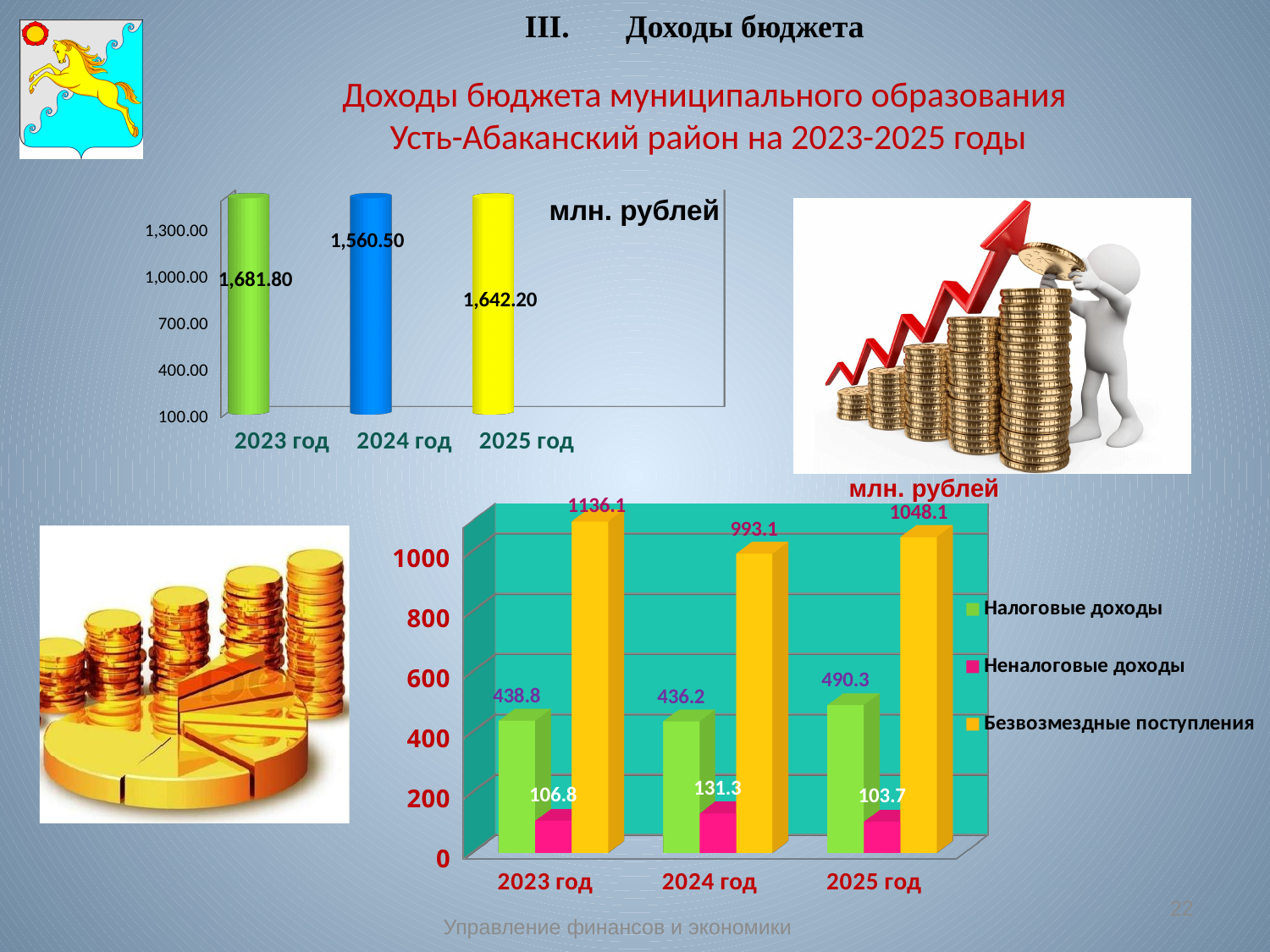
In the bottom chart, what is the difference between Безвозмездные поступления in 2023 год and 2024 год? 143.0 In the top chart, how many bars are plotted? 3 In the bottom chart, what is the value of Безвозмездные поступления for 2024 год? 993.1 In the top chart, what is the value for 2024 год? 1,560.50 How many series does the legend of the bottom chart list? 3 In the top chart, what is the value for 2023 год? 1,681.80 In the bottom chart, which is larger: Неналоговые доходы in 2024 год or in 2023 год? 2024 год What type of chart is the bottom chart? Bar chart In the bottom chart, what is the value of Неналоговые доходы for 2025 год? 103.7 In the top chart, which year has the lowest value according to the data labels? 2024 год In the top chart, what is the difference between the values for 2023 год and 2024 год? 121.30 In the bottom chart, which year has the highest value of Налоговые доходы? 2025 год